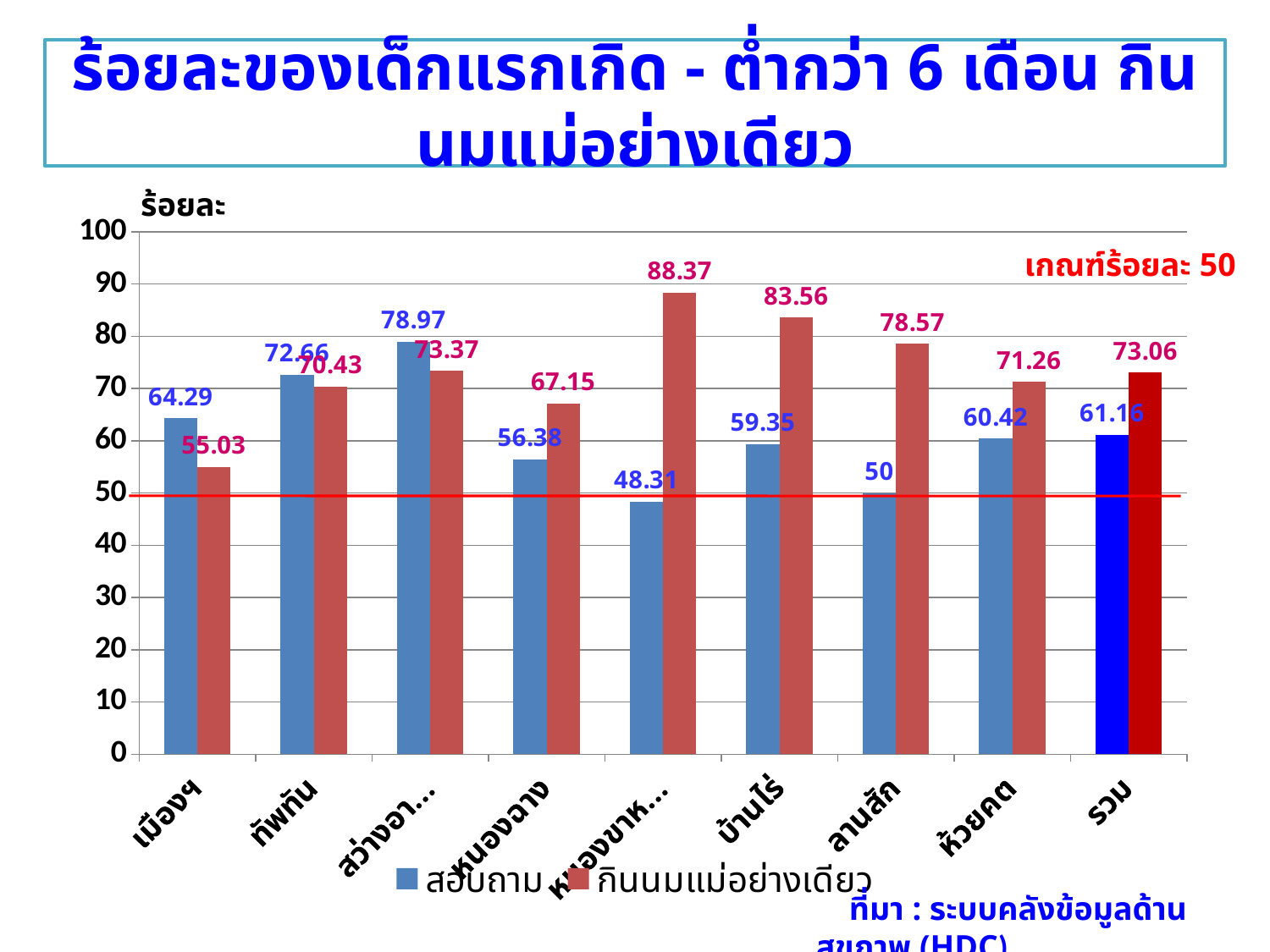
What type of chart is shown on the slide? bar chart How many series does the legend list? 2 What threshold value is marked by the red horizontal line on the chart? 50 Which category has the highest value for กินนมแม่อย่างเดียว? หนองขาห... How many categories are shown on the x axis? 9 What is the value of กินนมแม่อย่างเดียว for รวม? 73.06 Which category has the lowest value for สอบถาม? หนองขาห... What is the difference between the กินนมแม่อย่างเดียว and สอบถาม values for ห้วยคต? 10.84 What is the value of สอบถาม for ลานสัก? 50 What is the value of สอบถาม for เมืองฯ? 64.29 For ทัพทัน, which is larger: สอบถาม or กินนมแม่อย่างเดียว? สอบถาม What is the value of กินนมแม่อย่างเดียว for บ้านไร่? 83.56